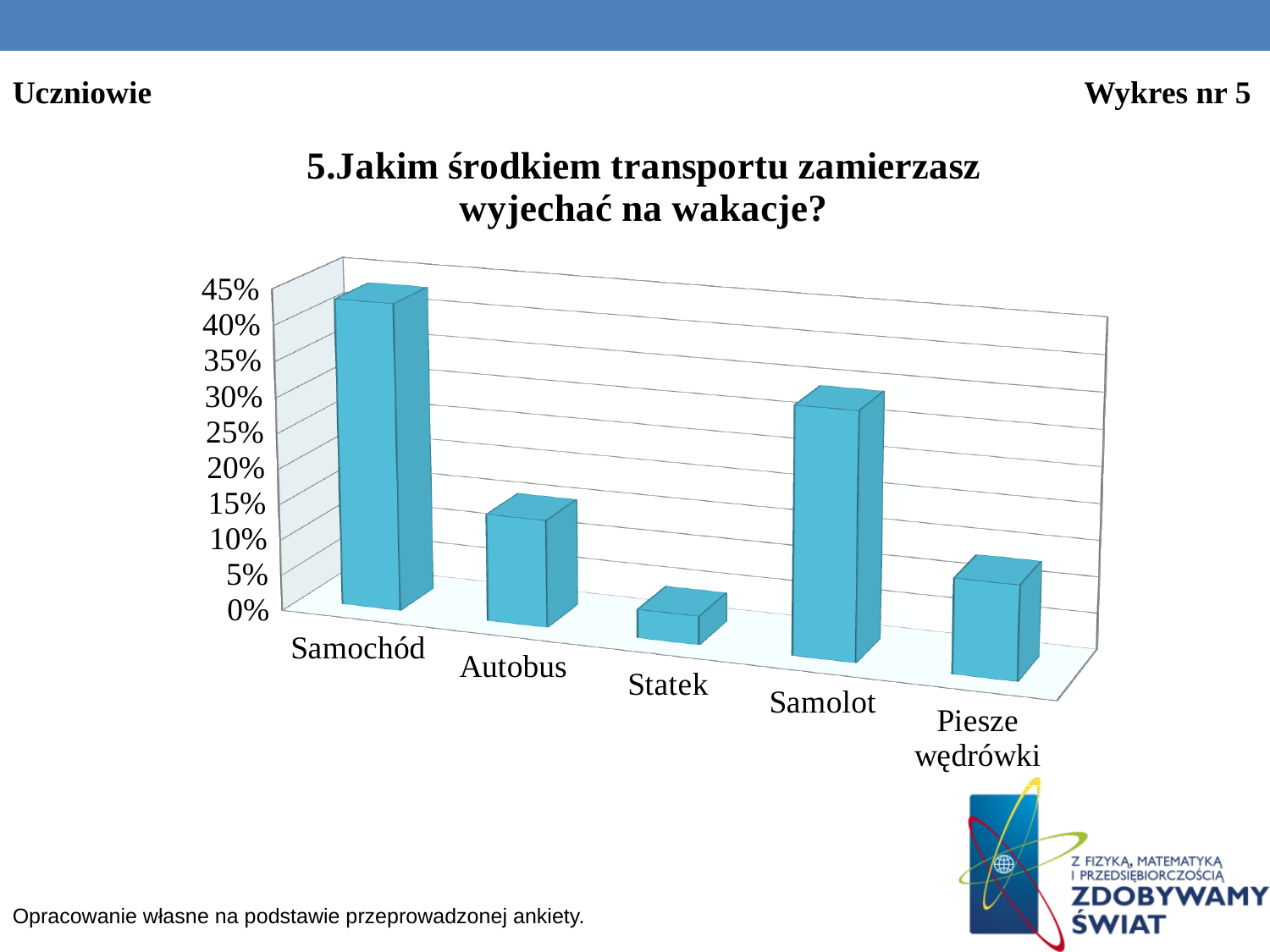
Is the value for Piesze wędrówki greater or less than 20%? less Is the value for Statek greater or less than 10%? less What is the title of the chart? 5.Jakim środkiem transportu zamierzasz wyjechać na wakacje? Is the value for Autobus greater or less than 20%? less Which means of transport has the lowest value on the chart? Statek How many categories (means of transport) are shown on the chart? 5 Which means of transport has the highest value on the chart? Samochód Which is larger, the value for Piesze wędrówki or the value for Statek? Piesze wędrówki Which is larger, the value for Samolot or the value for Autobus? Samolot What kind of chart is shown on the slide? bar chart